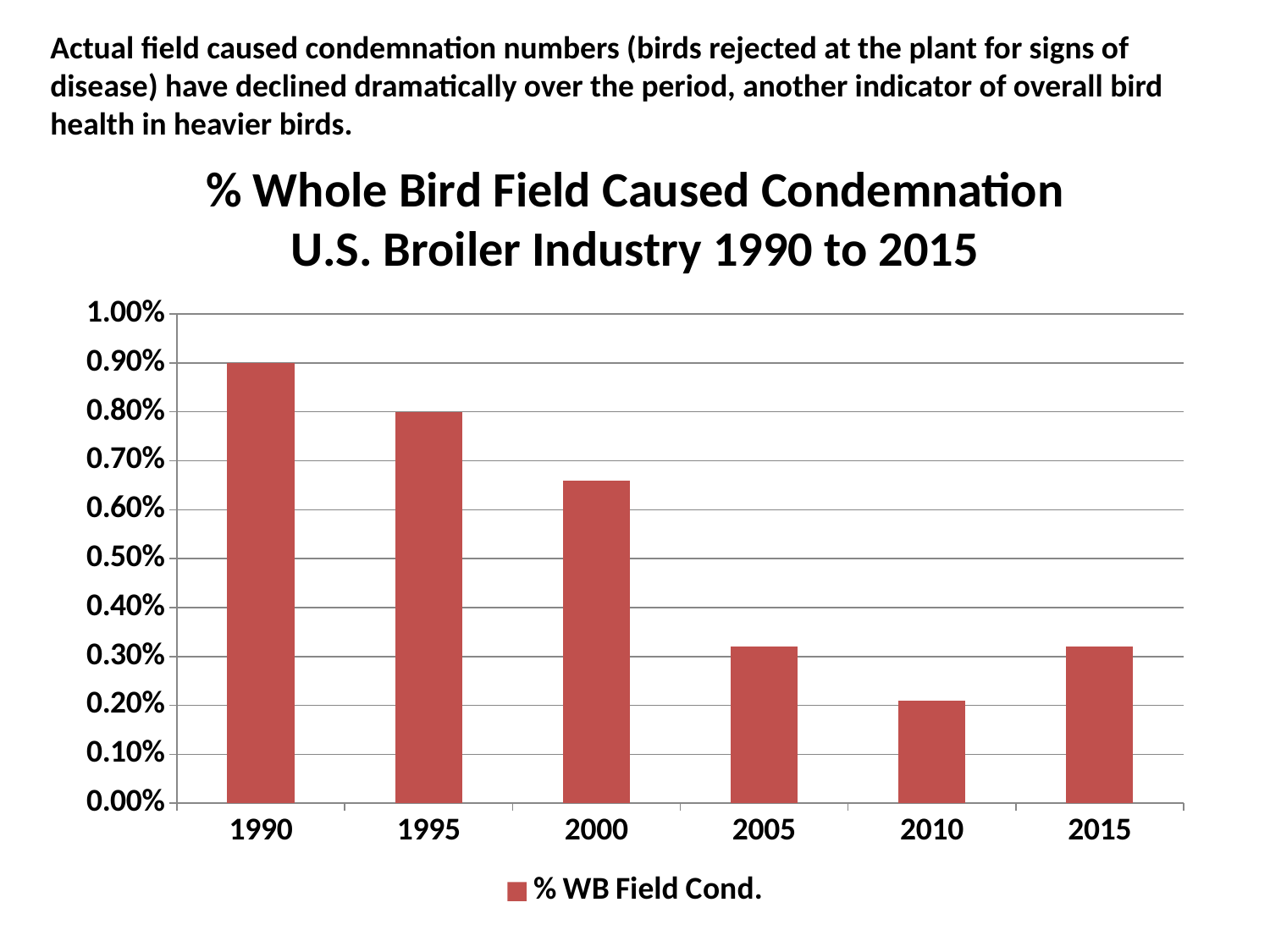
Is the value for 2010 greater or less than 0.30%? less What is the % WB Field Cond. value for 1990? 0.90% What is the name of the series shown in the legend? % WB Field Cond. Is the value for 2000 greater or less than 0.60%? greater Which year has the lowest % WB Field Cond. value? 2010 Which year has a larger value, 2000 or 2005? 2000 What is the % WB Field Cond. value for 1995? 0.80% What is the difference between the 1990 and 1995 values? 0.10% How many years are shown on the x axis of the chart? 6 Which year has the highest % WB Field Cond. value? 1990 What type of chart is shown on the slide? bar chart How many series does the legend list? 1